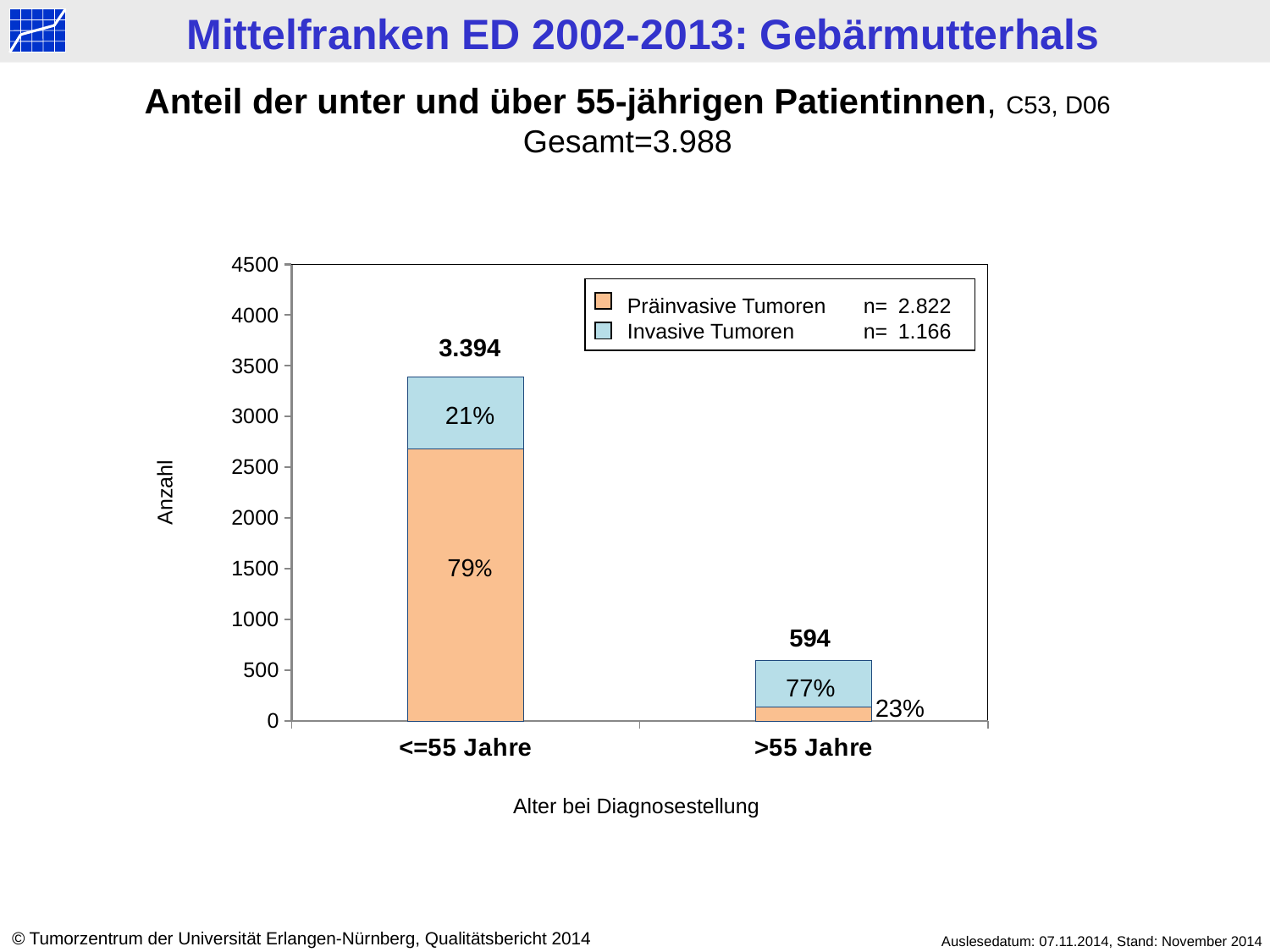
What kind of chart is shown on the slide? Stacked bar chart What is the total number of patients shown for the <=55 Jahre bar? 3.394 What percentage of the <=55 Jahre bar is Präinvasive Tumoren? 79% Is the Präinvasive Tumoren segment of the <=55 Jahre bar greater or less than 2500? greater Which age group has the higher total number of patients? <=55 Jahre What percentage of the >55 Jahre bar is Präinvasive Tumoren? 23% How many age categories are shown on the x axis? 2 What percentage of the >55 Jahre bar is Invasive Tumoren? 77% What is the total number of patients shown for the >55 Jahre bar? 594 What is the difference between the totals of the <=55 Jahre and >55 Jahre bars? 2.800 What percentage of the <=55 Jahre bar is Invasive Tumoren? 21% How many series does the legend list? 2